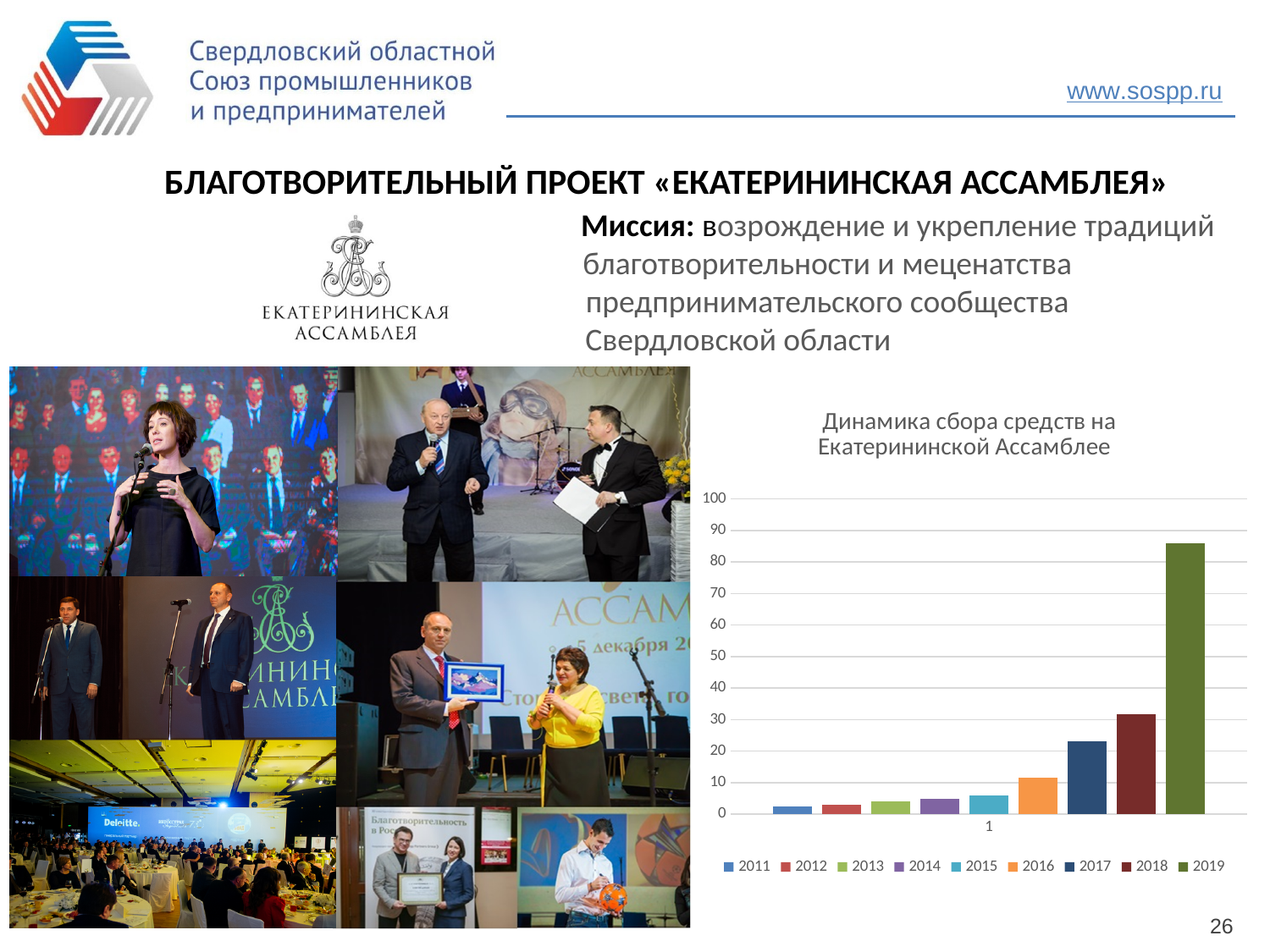
Is the value for 2017 greater or less than 20? greater What is the title of the chart? Динамика сбора средств на Екатерининской Ассамблее Which year has the lowest bar in the chart? 2011 Is the value for 2019 greater or less than 80? greater What kind of chart is shown on the slide? bar chart Which is larger, the value for 2018 or the value for 2017? 2018 Is the value for 2016 greater or less than 20? less Which year has the highest bar in the chart? 2019 Do the bars rise or fall from 2011 to 2019? rise How many series does the chart legend list? 9 What is the highest value shown on the vertical axis? 100